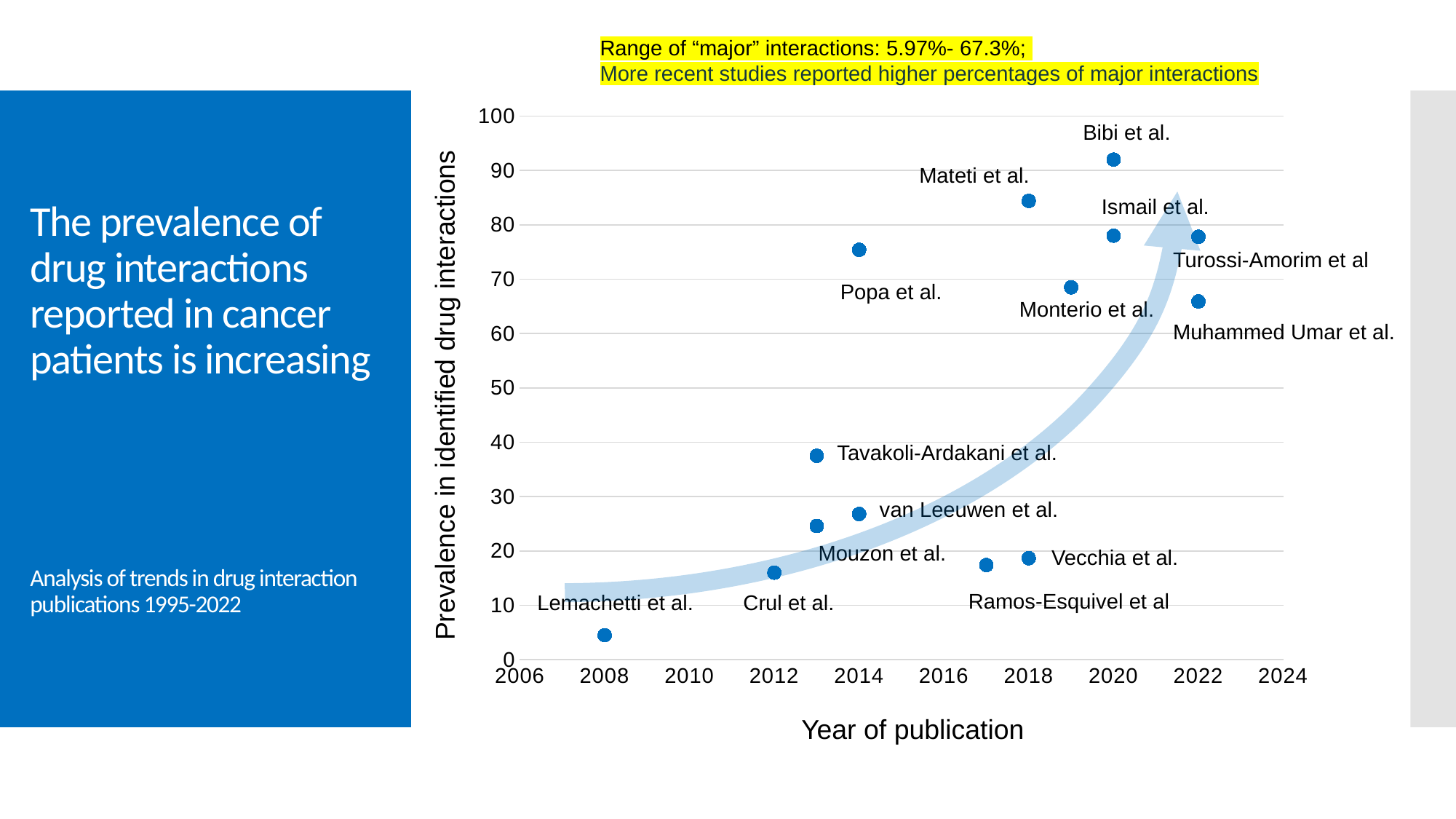
Is the prevalence value for Lemachetti et al. greater or less than 10? less Which study has the highest prevalence of identified drug interactions on the chart? Bibi et al. What is the title of the x axis of the chart? Year of publication How many studies (data points) are plotted on the chart? 14 Is the prevalence value for Tavakoli-Ardakani et al. greater or less than 40? less Is the prevalence value for Popa et al. greater or less than 70? greater What kind of chart is shown on the slide? Scatter chart Which study has the lowest prevalence of identified drug interactions on the chart? Lemachetti et al. Which study reports a higher prevalence, Mateti et al. or Monterio et al.? Mateti et al. Which study reports a higher prevalence, Popa et al. or Tavakoli-Ardakani et al.? Popa et al. According to the chart, does the prevalence of drug interactions generally rise or fall with year of publication? Rise